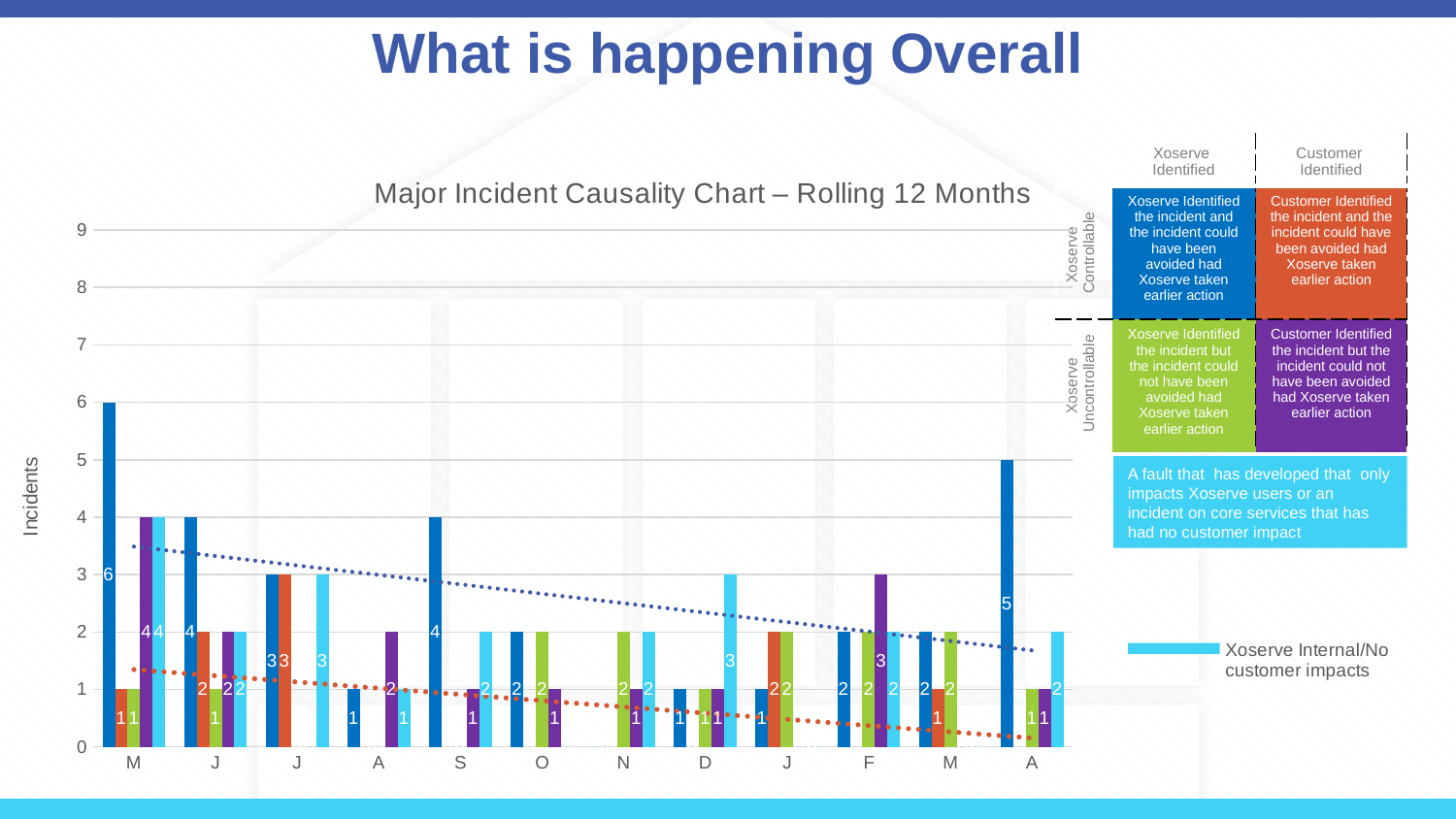
What is the value of the light blue bar in the month D? 3 Is the dark blue bar in the first month (M) greater or less than 5? greater In which month does the dark blue series reach its highest value? M (first month) What is the value of the tallest dark blue bar, in the first month (M)? 6 What is the title of the chart? Major Incident Causality Chart – Rolling 12 Months What is the value of the dark blue bar in the last month (A)? 5 What is the difference between the dark blue bar in the first month (M, 6) and the dark blue bar in the last month (A, 5)? 1 How many months are shown along the x axis of the chart? 12 What is the label on the y axis of the chart? Incidents What is the value of the purple bar in the first month (M)? 4 Do the dotted trend lines rise or fall from left to right across the chart? fall What type of chart is used to show the incidents? bar chart